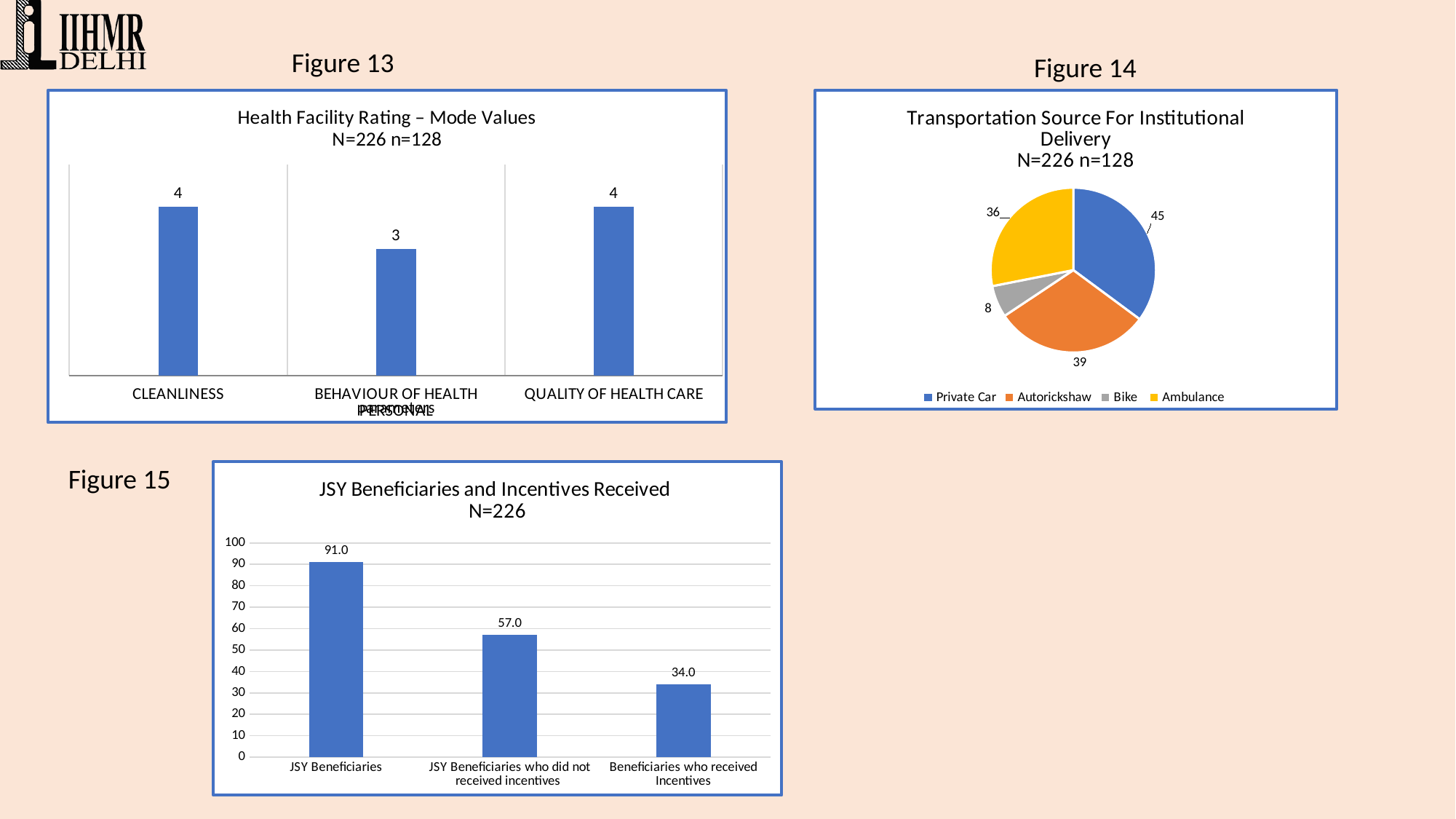
In the 'Transportation Source For Institutional Delivery' pie chart, what is the value for Ambulance? 36 In the 'Health Facility Rating – Mode Values' chart, what is the value for CLEANLINESS? 4 How many entries does the legend of the 'Transportation Source For Institutional Delivery' chart list? 4 In the 'JSY Beneficiaries and Incentives Received' chart, do the values rise or fall from left to right? fall How many categories are shown in the 'Health Facility Rating – Mode Values' chart? 3 In the 'Transportation Source For Institutional Delivery' pie chart, what is the difference between Private Car and Bike? 37 What kind of chart is 'Transportation Source For Institutional Delivery'? pie chart In the 'JSY Beneficiaries and Incentives Received' chart, what is the difference between 'JSY Beneficiaries' and 'JSY Beneficiaries who did not received incentives'? 34.0 In the 'Transportation Source For Institutional Delivery' pie chart, which source has the largest value? Private Car What kind of chart is 'JSY Beneficiaries and Incentives Received'? bar chart In the 'JSY Beneficiaries and Incentives Received' chart, what is the value for 'Beneficiaries who received Incentives'? 34.0 In the 'Health Facility Rating – Mode Values' chart, which category has the lowest value? BEHAVIOUR OF HEALTH PERSONAL